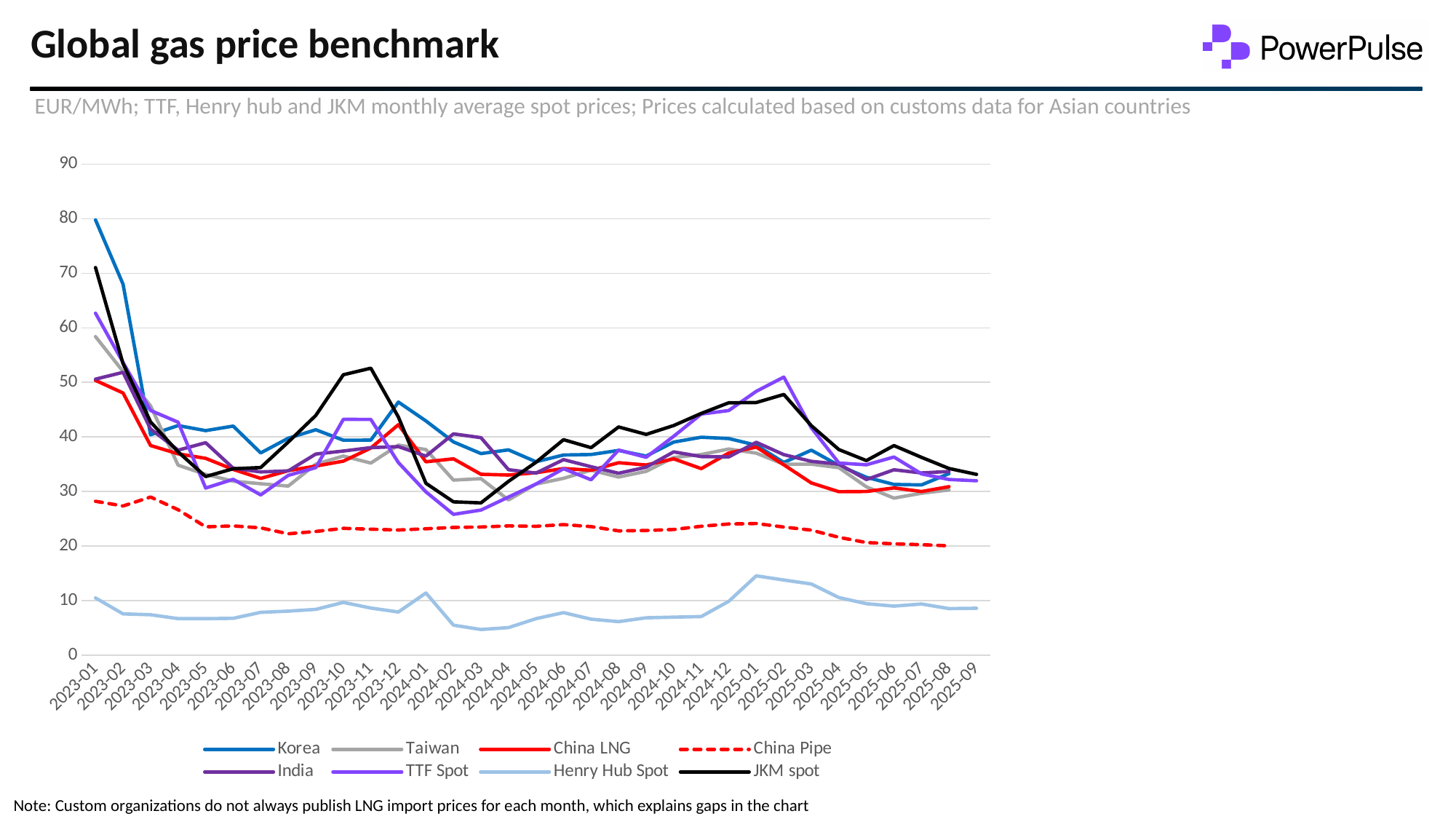
Is the value for China Pipe in 2025-08 greater or less than 30? less How many months are shown along the x axis? 33 Which series is drawn as a dashed line? China Pipe In 2025-02, which is larger: TTF Spot or Henry Hub Spot? TTF Spot Is the value for Henry Hub Spot in 2025-01 greater or less than 10? greater Is the value for JKM spot in 2023-11 greater or less than 40? greater How many series does the legend list? 8 What kind of chart is shown on the slide? line chart Does the Korea line rise or fall from 2023-01 to 2023-03? fall Which series has the lowest value in 2023-01? Henry Hub Spot Which series has the highest value in 2023-01? Korea